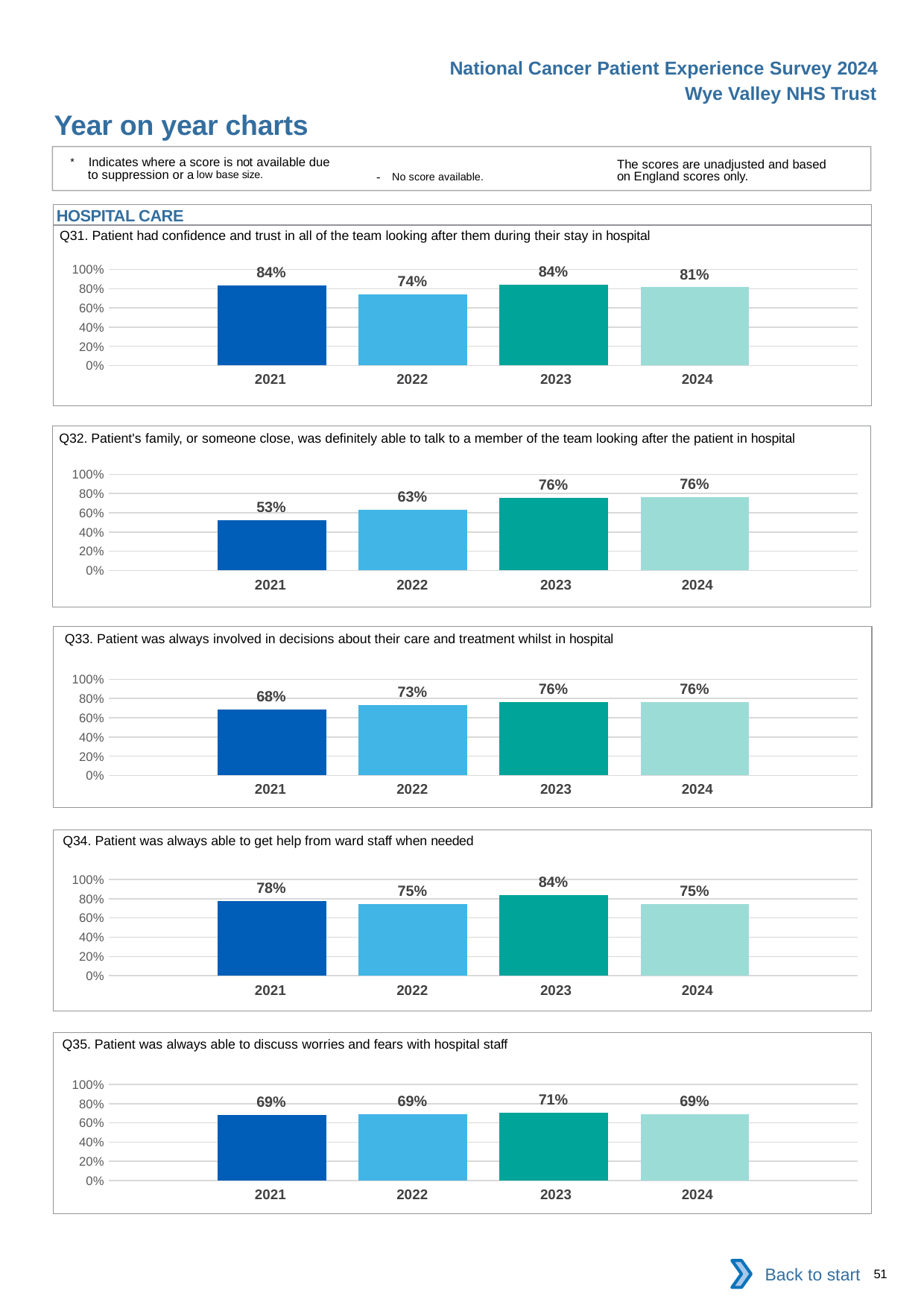
In the Q31 chart, is the value for 2024 greater or less than 60%? greater In the Q35 chart, how many years are plotted? 4 In the Q33 chart, do the values rise or fall from 2021 to 2023? rise What kind of chart is the Q31 chart? bar chart What is the section heading above the Q31 chart? HOSPITAL CARE In the Q32 chart, what is the difference between the 2024 value and the 2021 value? 23 percentage points In the Q32 chart, which year has the lowest value? 2021 In the Q33 chart, what is the difference between the 2022 value and the 2021 value? 5 percentage points In the Q31 chart, what is the value for 2022? 74% In the Q34 chart, is the value for 2021 larger or smaller than the value for 2024? larger In the Q35 chart, what is the value for 2023? 71% In the Q34 chart, which year has the highest value? 2023